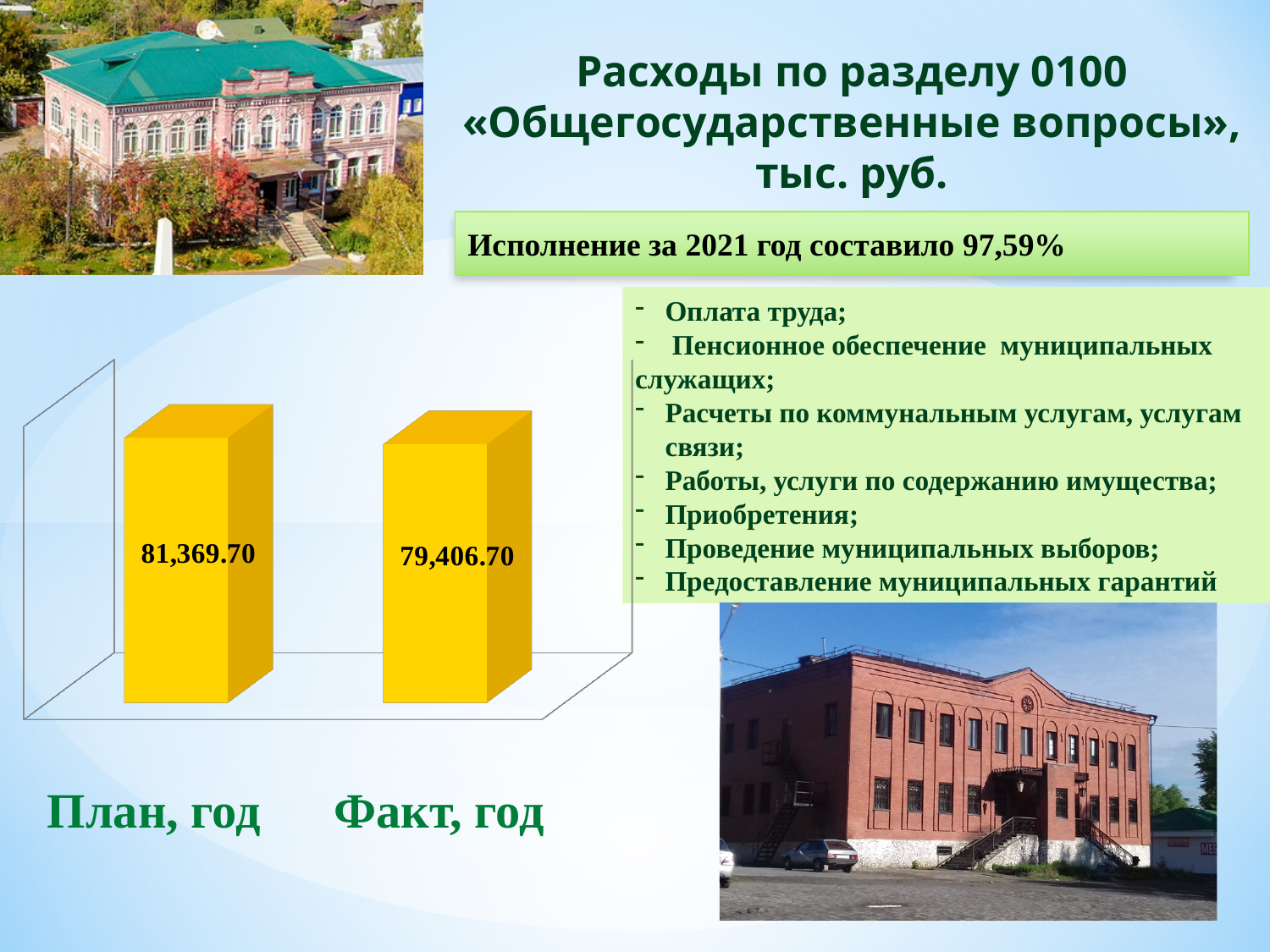
How many bars are shown on the chart? 2 Is the value for «Факт, год» larger or smaller than the value for «План, год»? smaller Which bar has the lowest value on the chart? Факт, год In what units are the chart values expressed, according to the slide title? тыс. руб. Do the values rise or fall from «План, год» to «Факт, год»? fall What is the value of the bar labelled «Факт, год»? 79,406.70 What colour are the bars on the chart? yellow Which bar is higher, «План, год» or «Факт, год»? План, год What type of chart is shown on the slide? bar chart What is the value of the bar labelled «План, год»? 81,369.70 What is the difference between the «План, год» and «Факт, год» values? 1,963.00